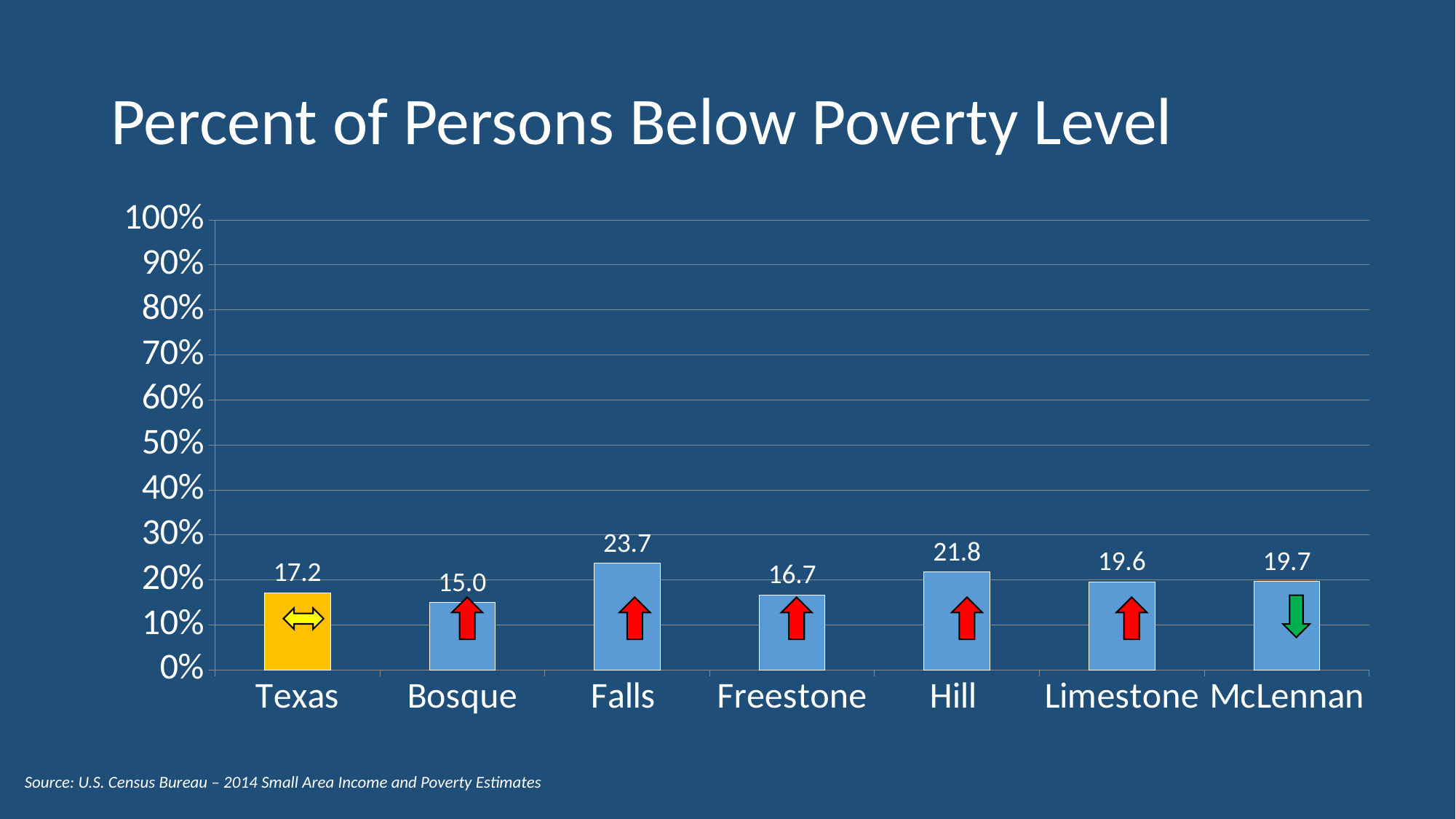
Which category has the lowest value? Bosque What is the value for Falls? 23.7 Which is larger, the value for Freestone or the value for Hill? Hill What is the difference between the values for Hill and Texas? 4.6 How many categories are shown on the x axis? 7 Is the value for Falls greater or less than 20%? greater What is the value for McLennan? 19.7 Which category has the highest value? Falls What is the value for Texas? 17.2 What kind of chart is shown on the slide? bar chart What is the difference between the values for Falls and Bosque? 8.7 What is the title of the chart? Percent of Persons Below Poverty Level